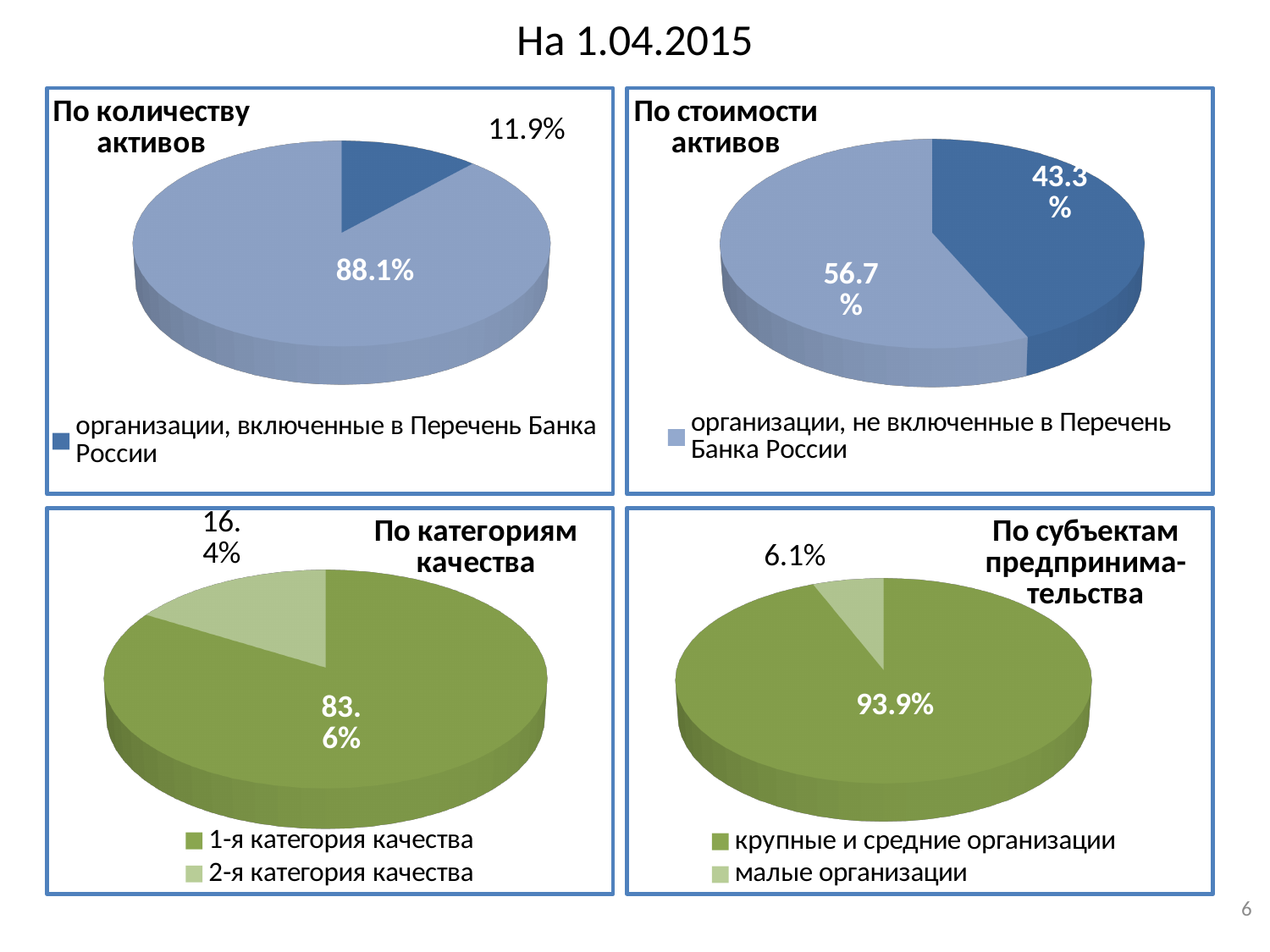
In the chart 'По стоимости активов', what is the difference between the two slices? 13.4% In the chart 'По категориям качества', what share is shown for 2-я категория качества? 16.4% In the chart 'По субъектам предпринимательства', what share is shown for малые организации? 6.1% In the chart 'По количеству активов', what is the value of the largest slice? 88.1% How many pie charts are shown on the slide? 4 In the chart 'По количеству активов', what share is shown for организации, включенные в Перечень Банка России? 11.9% In the chart 'По субъектам предпринимательства', which category has the larger share? крупные и средние организации Which is larger: the share of организации, включенные в Перечень Банка России in 'По количеству активов' or in 'По стоимости активов'? По стоимости активов What type of chart is used for 'По категориям качества'? pie chart In the chart 'По стоимости активов', what share is shown for организации, включенные в Перечень Банка России? 43.3% In the chart 'По категориям качества', what share is shown for 1-я категория качества? 83.6% In the chart 'По стоимости активов', what share is shown for организации, не включенные в Перечень Банка России? 56.7%